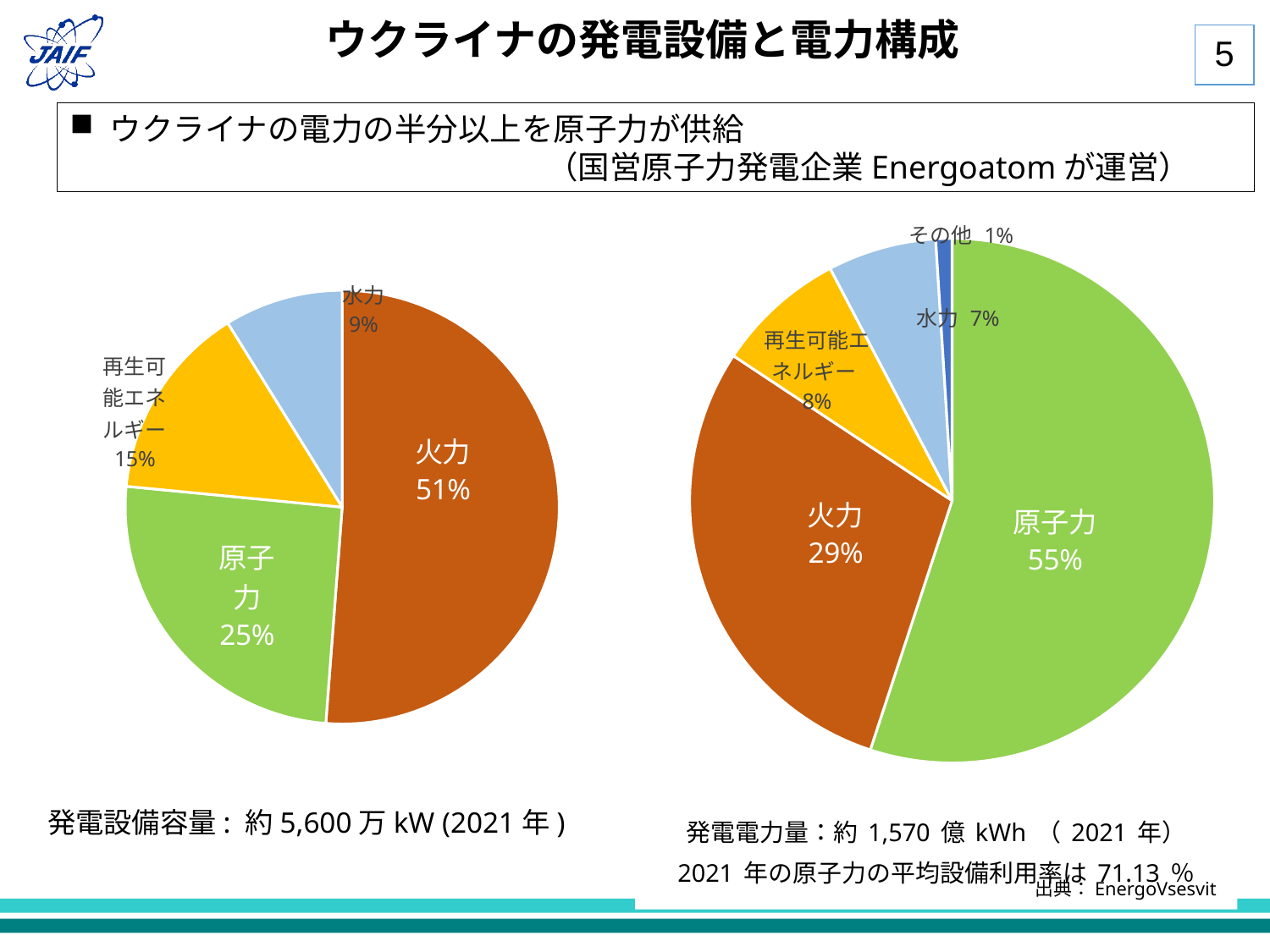
In the right pie chart, what share does その他 have? 1% In the left pie chart, which category has the largest share? 火力 In the left pie chart, what share does 火力 have? 51% In the right pie chart, what share does 火力 have? 29% What type of chart is used on the right side of the slide? Pie chart In the right pie chart, what share does 原子力 have? 55% In the right pie chart, how many slices are there? 5 In the left pie chart, what share does 原子力 have? 25% In the left pie chart, which category has the smallest share? 水力 In the left pie chart, what share does 再生可能エネルギー have? 15% In the left pie chart, how many slices are there? 4 In the right pie chart, what is the difference between the shares of 原子力 and 火力? 26 percentage points